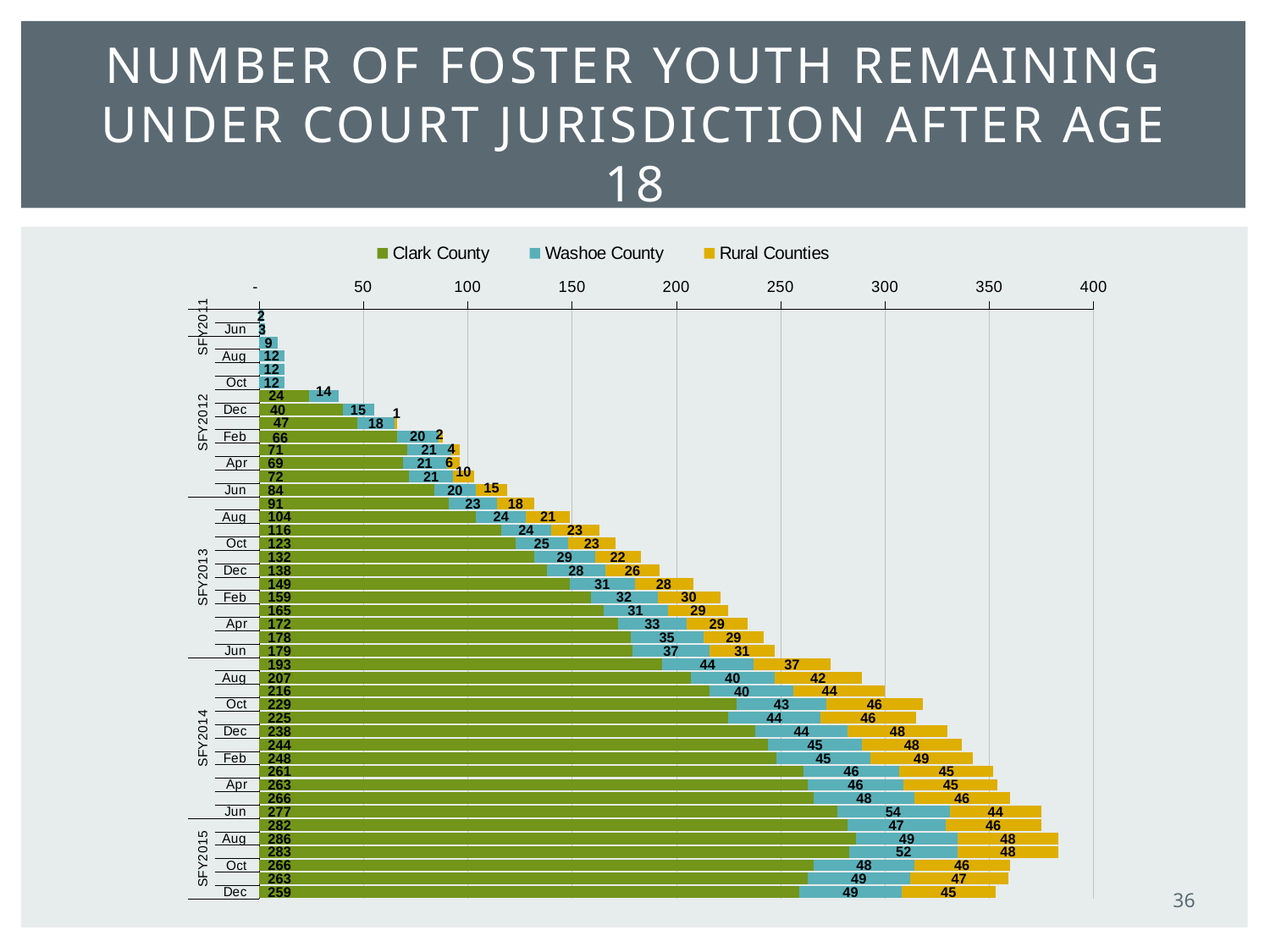
What is the Washoe County value for Dec of SFY2015? 49 Do the Clark County values generally rise or fall from SFY2011 through SFY2014? Rise Which is larger, the Clark County value for Dec of SFY2015 or for Dec of SFY2014? Dec of SFY2015 What kind of chart is shown on the slide? Stacked bar chart What is the Clark County value for Oct of SFY2013? 123 What is the highest Washoe County value shown on the chart? 54 Which three series are listed in the legend? Clark County, Washoe County, Rural Counties What is the total of the stacked bar for Dec of SFY2015 (Clark County 259, Washoe County 49, Rural Counties 45)? 353 What is the Clark County value for Dec of SFY2015? 259 What is the difference between the Clark County value for Aug of SFY2015 (286) and Dec of SFY2015 (259)? 27 What is the highest Clark County value shown on the chart? 286 How many series does the legend list? 3